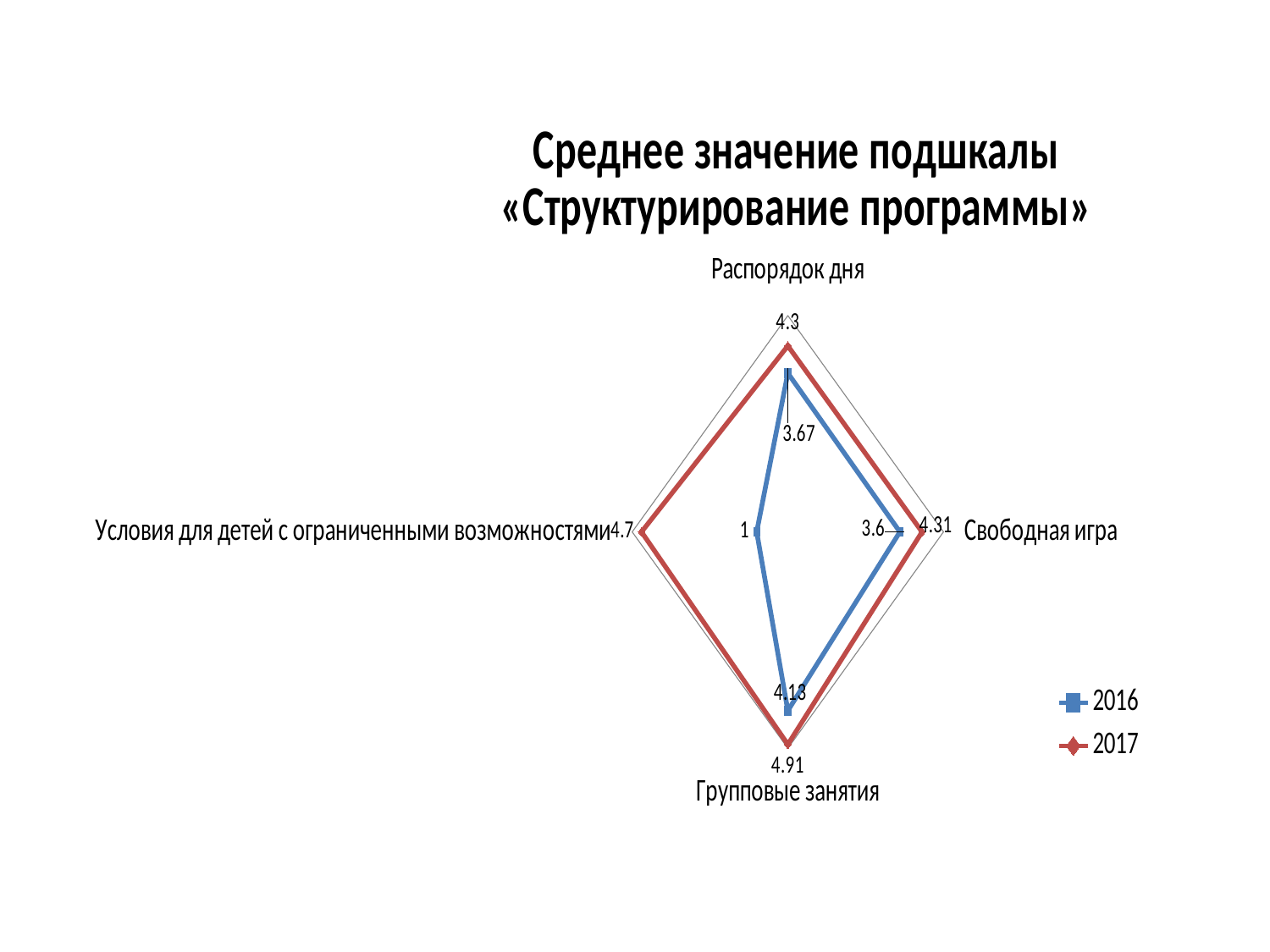
How many categories are plotted on the chart? 4 What is the difference between the 2017 and 2016 values for Групповые занятия? 0.78 What is the 2017 value for Распорядок дня? 4.3 What is the 2017 value for Групповые занятия? 4.91 What is the 2016 value for Условия для детей с ограниченными возможностями? 1 What type of chart is shown on the slide? Radar chart Which category has the highest 2017 value? Групповые занятия Which category has the lowest 2016 value? Условия для детей с ограниченными возможностями How many series does the legend list? 2 What is the 2016 value for Свободная игра? 3.6 What is the 2017 value for Условия для детей с ограниченными возможностями? 4.7 What is the 2016 value for Распорядок дня? 3.67